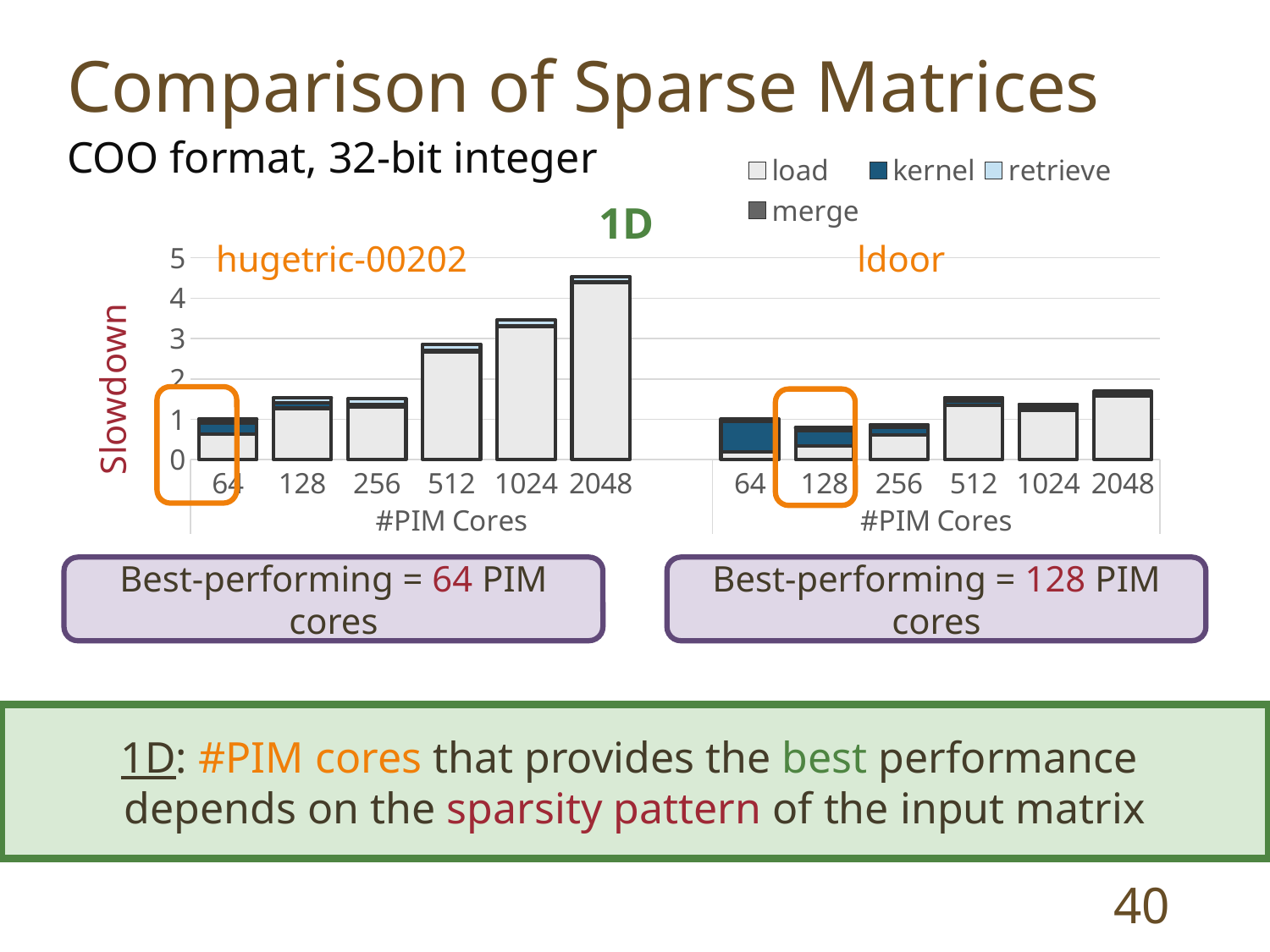
What is the label of the y axis on the charts? Slowdown In the hugetric-00202 chart, which has the larger slowdown: 1024 or 2048 PIM cores? 2048 How many series does the legend list? 4 In the ldoor chart, which #PIM Cores value has the lowest slowdown? 128 What kind of chart is used for hugetric-00202? stacked bar chart In the hugetric-00202 chart, which #PIM Cores value has the lowest slowdown? 64 In the ldoor chart, is the slowdown for 512 PIM cores greater or less than 1? greater In the hugetric-00202 chart, is the slowdown for 512 PIM cores greater or less than 3? less How many #PIM Cores categories are shown in the ldoor chart? 6 In the hugetric-00202 chart, does the slowdown generally rise or fall as #PIM Cores increases from 64 to 2048? rise In the hugetric-00202 chart, which #PIM Cores value has the highest slowdown? 2048 In the hugetric-00202 chart, is the slowdown for 2048 PIM cores greater or less than 4? greater